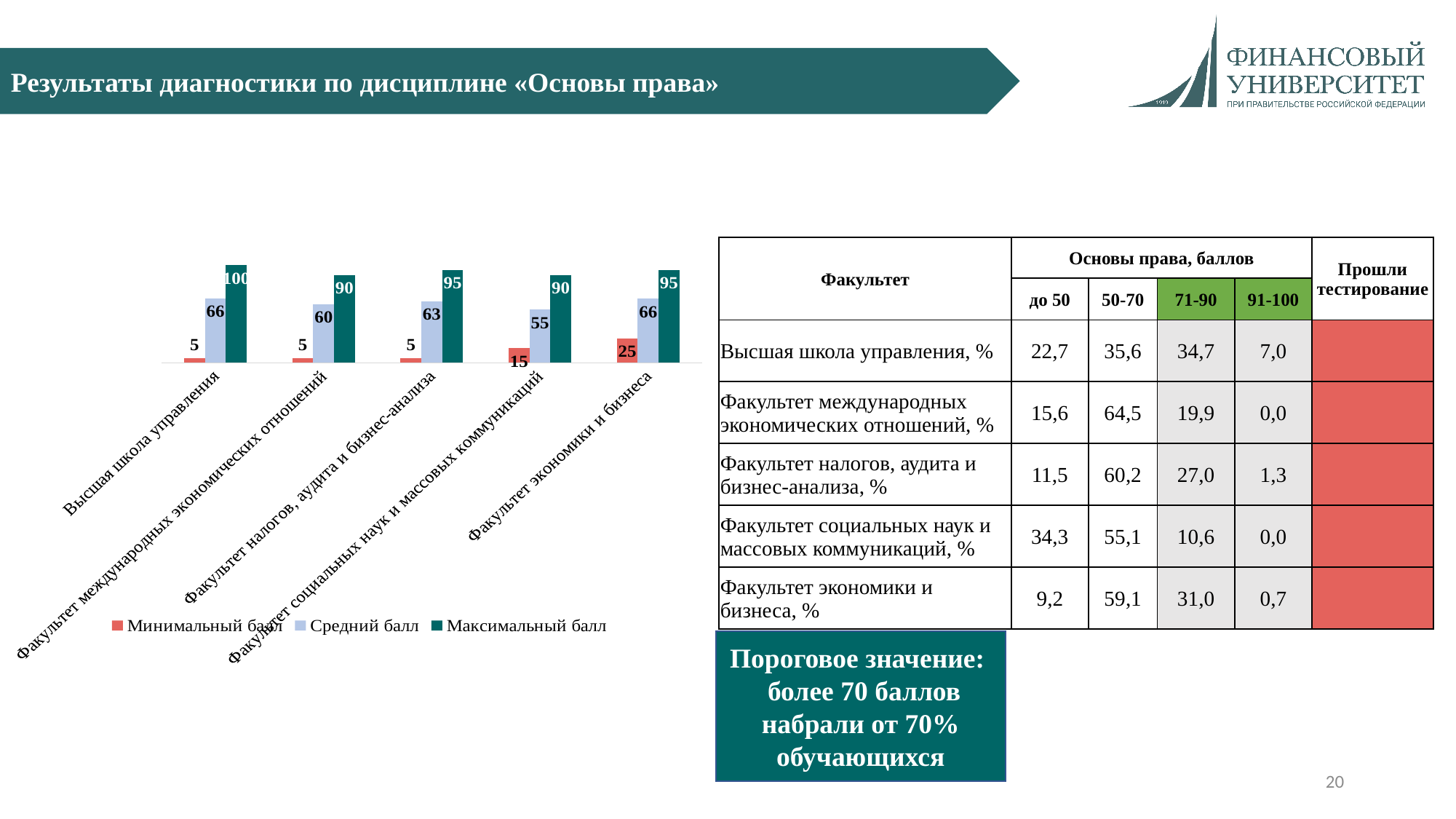
Which faculty has the lowest average score (Средний балл)? Факультет социальных наук и массовых коммуникаций How many series does the chart legend list? 3 Which is larger: the average score for Факультет налогов, аудита и бизнес-анализа or for Факультет международных экономических отношений? Факультет налогов, аудита и бизнес-анализа Which faculty has the highest minimum score (Минимальный балл)? Факультет экономики и бизнеса What type of chart is shown on the slide? Bar chart Which series in the chart legend is shown in red? Минимальный балл What is the maximum score (Максимальный балл) for Высшая школа управления? 100 What is the difference between the average scores of Высшая школа управления and Факультет международных экономических отношений? 6 What is the difference between the maximum and minimum score for Факультет социальных наук и массовых коммуникаций? 75 What is the average score (Средний балл) for Факультет социальных наук и массовых коммуникаций? 55 How many faculties are shown on the chart? 5 What is the minimum score (Минимальный балл) for Факультет экономики и бизнеса? 25